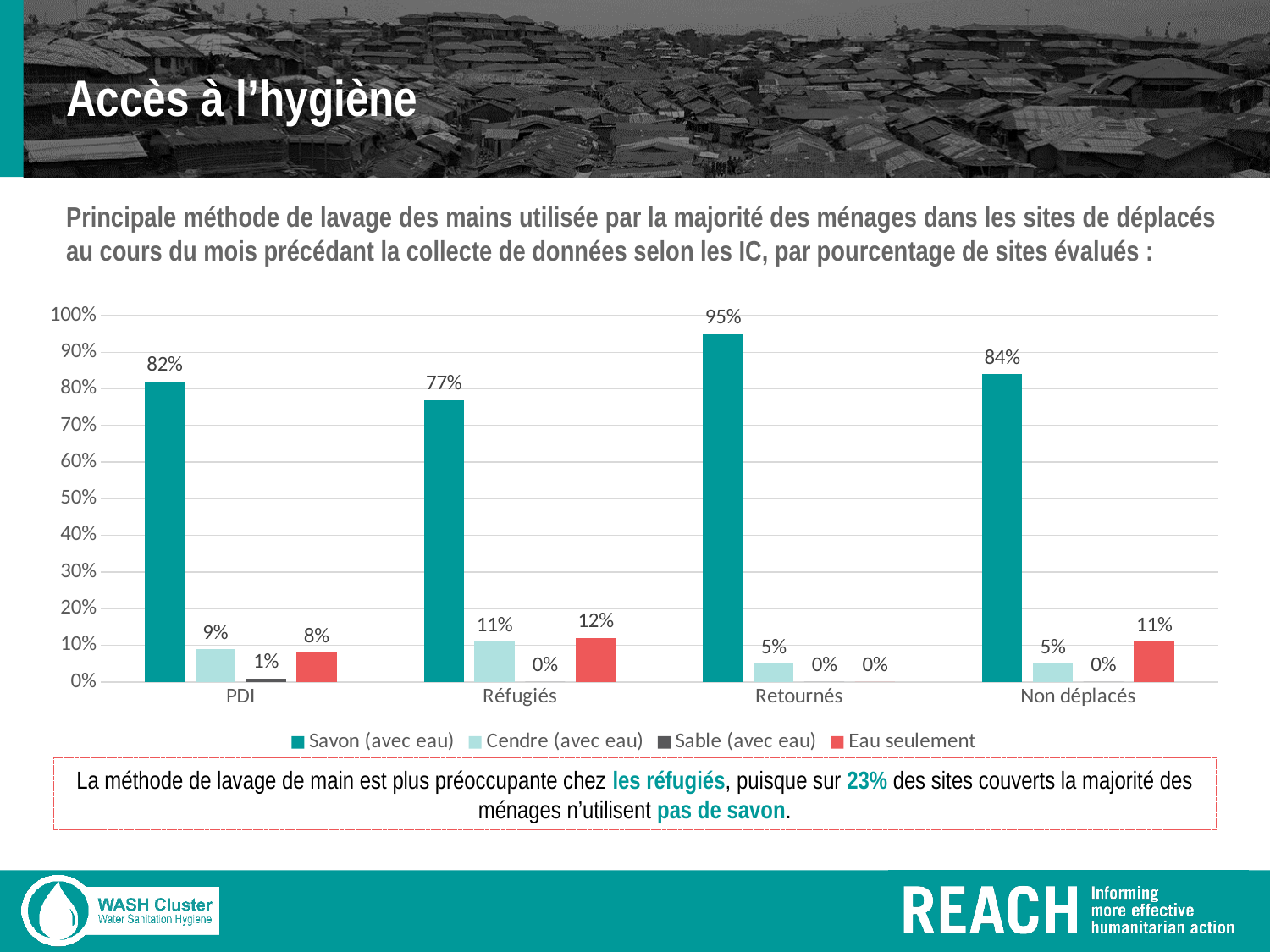
What kind of chart is shown on the slide? Bar chart What is the value for Savon (avec eau) in the Retournés category? 95% Which category has the lowest value for Savon (avec eau)? Réfugiés How many categories are shown on the x axis? 4 How many series does the legend list? 4 What is the value for Sable (avec eau) in the PDI category? 1% Which category has the highest value for Savon (avec eau)? Retournés What is the value for Eau seulement in the Réfugiés category? 12% What is the difference between the Savon (avec eau) values for Retournés and PDI? 13% Which series is shown in red in the legend? Eau seulement Which is larger: Eau seulement for Non déplacés or Eau seulement for PDI? Non déplacés What is the value for Cendre (avec eau) in the PDI category? 9%